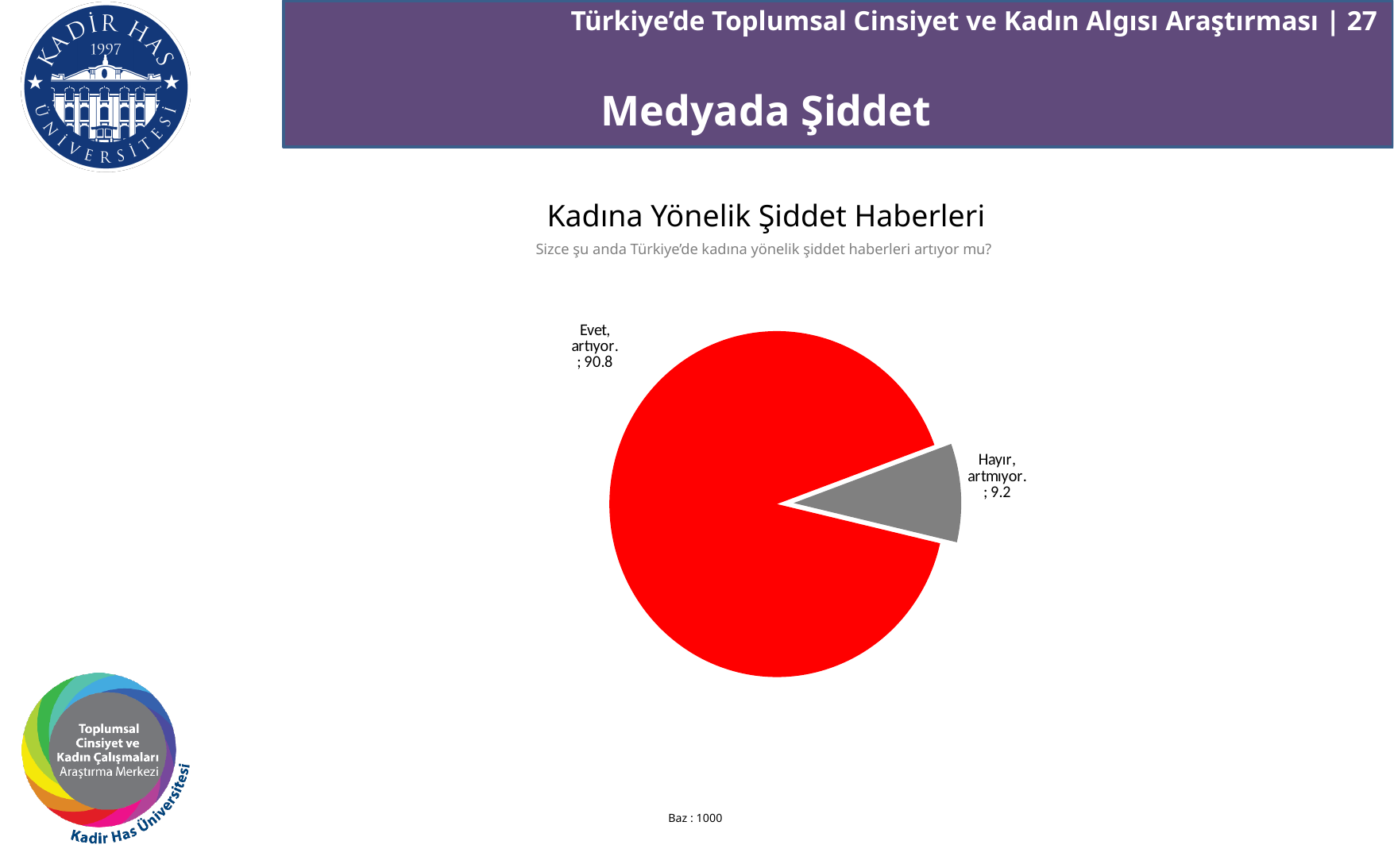
What kind of chart is shown on the slide? Pie chart How many slices does the pie chart have? 2 What is the title of the chart on the slide? Kadına Yönelik Şiddet Haberleri What is the total of the two slice values in the pie chart? 100 What base (Baz) size is shown below the pie chart? 1000 What is the difference between the "Evet, artıyor." and "Hayır, artmıyor." values in the pie chart? 81.6 What colour is the "Hayır, artmıyor." slice of the pie chart? Grey Which slice of the pie chart is the largest? Evet, artıyor. What value is shown for the "Evet, artıyor." slice of the pie chart? 90.8 What value is shown for the "Hayır, artmıyor." slice of the pie chart? 9.2 Which is larger in the pie chart: "Evet, artıyor." or "Hayır, artmıyor."? Evet, artıyor. Which slice of the pie chart is the smallest? Hayır, artmıyor.